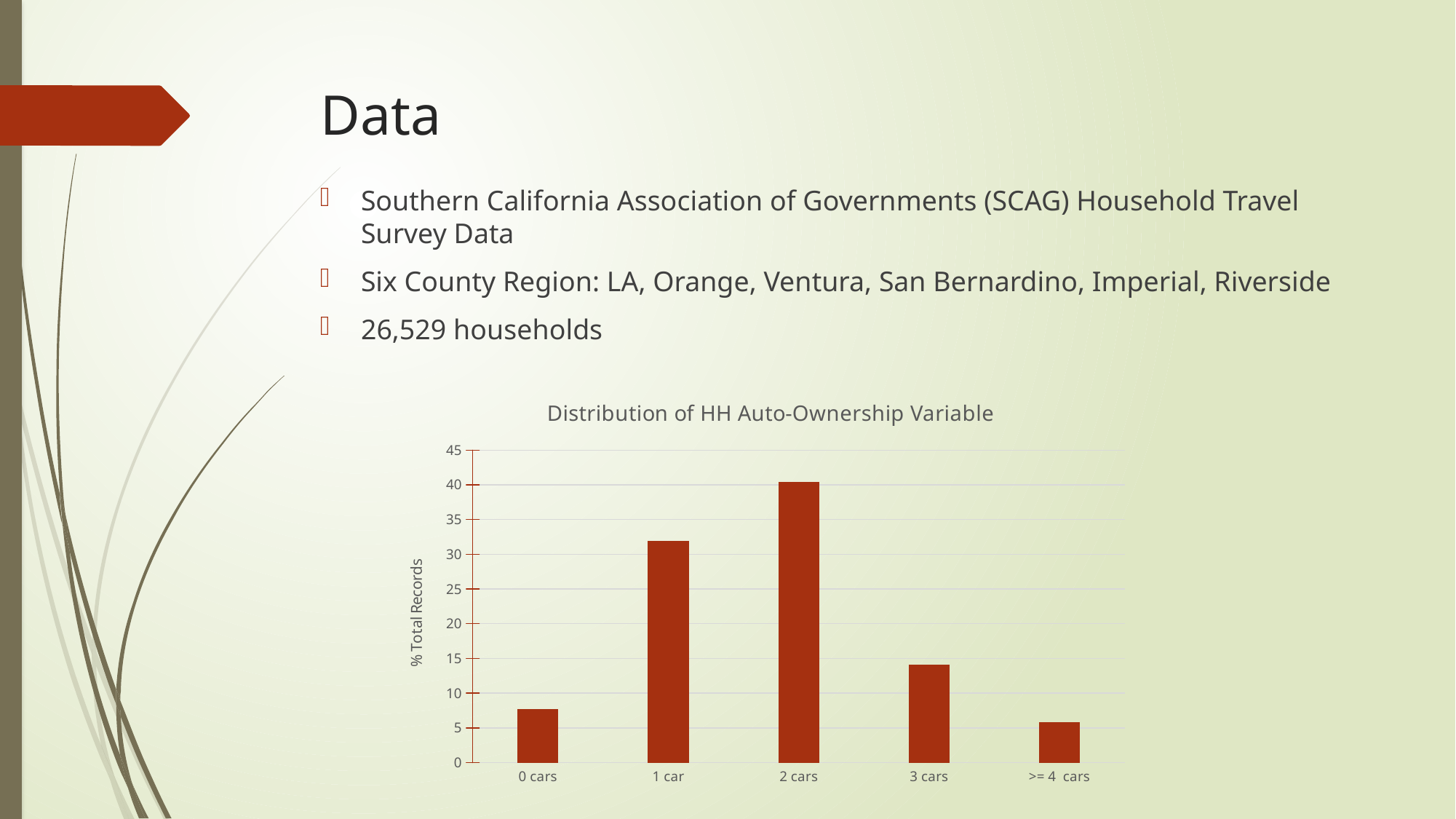
Which is larger, the value for 1 car or the value for 3 cars? 1 car Which is larger, the value for 0 cars or the value for >= 4 cars? 0 cars Which category has the highest value in the chart? 2 cars Is the value for 1 car greater or less than 30? greater What is the title of the chart? Distribution of HH Auto-Ownership Variable Is the value for 0 cars greater or less than 10? less What is the label of the y axis of the chart? % Total Records Is the value for 3 cars greater or less than 15? less Which category has the lowest value in the chart? >= 4 cars How many categories are shown on the x axis of the chart? 5 What kind of chart is shown on the slide? bar chart